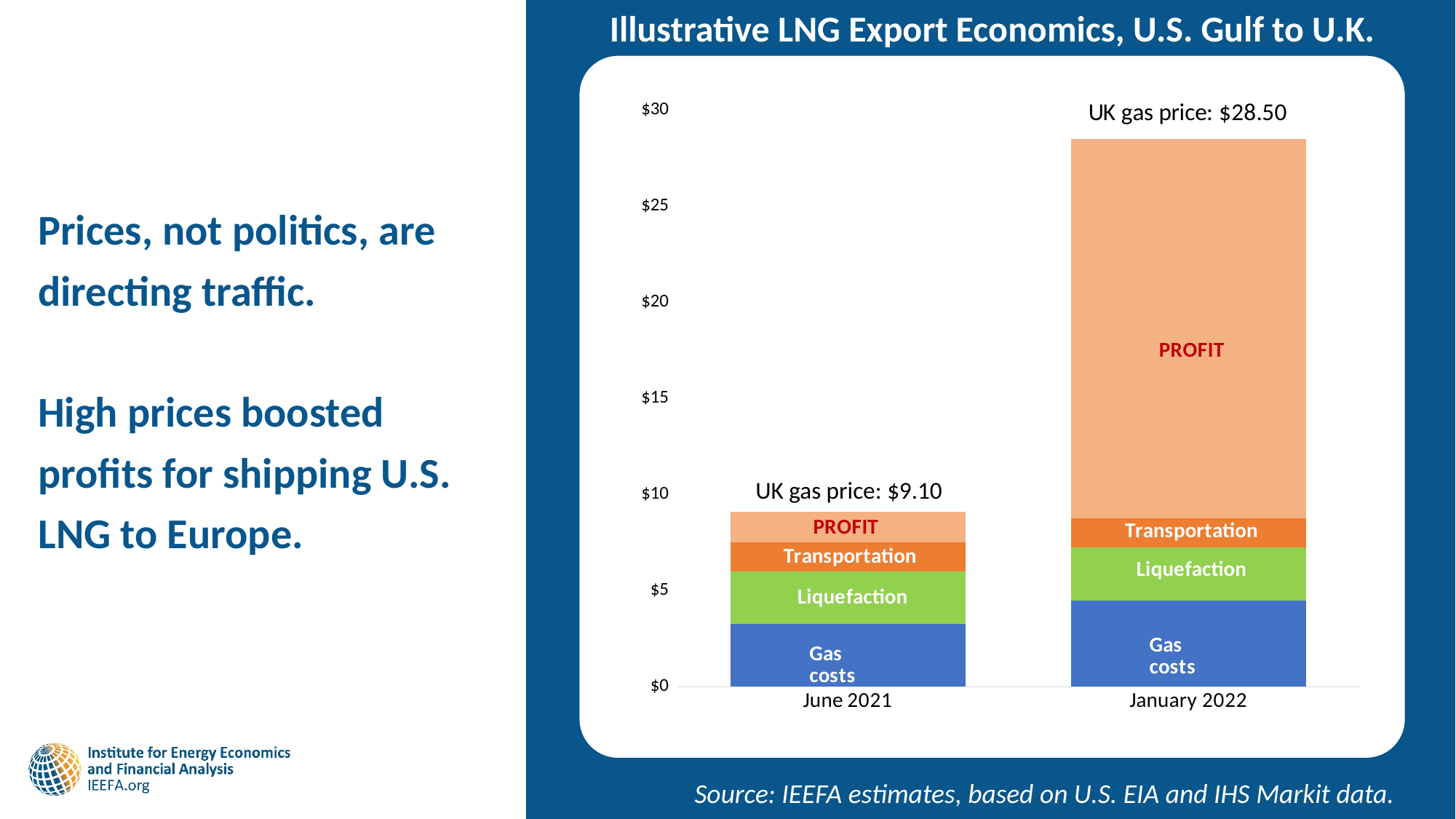
Is the total height of the June 2021 bar greater or less than $10? less What is the UK gas price shown for June 2021? $9.10 What is the difference between the UK gas price in January 2022 and in June 2021? $19.40 Which period has the tallest stacked bar? January 2022 Is the PROFIT segment of the January 2022 bar greater or less than $15? greater Do the bar totals rise or fall from June 2021 to January 2022? Rise What is the title of the chart? Illustrative LNG Export Economics, U.S. Gulf to U.K. Is the total height of the January 2022 bar greater or less than $25? greater How many time periods (categories) are shown on the x axis? 2 What kind of chart is shown on the slide? Stacked bar chart Which period has the higher UK gas price, June 2021 or January 2022? January 2022 What is the UK gas price shown for January 2022? $28.50